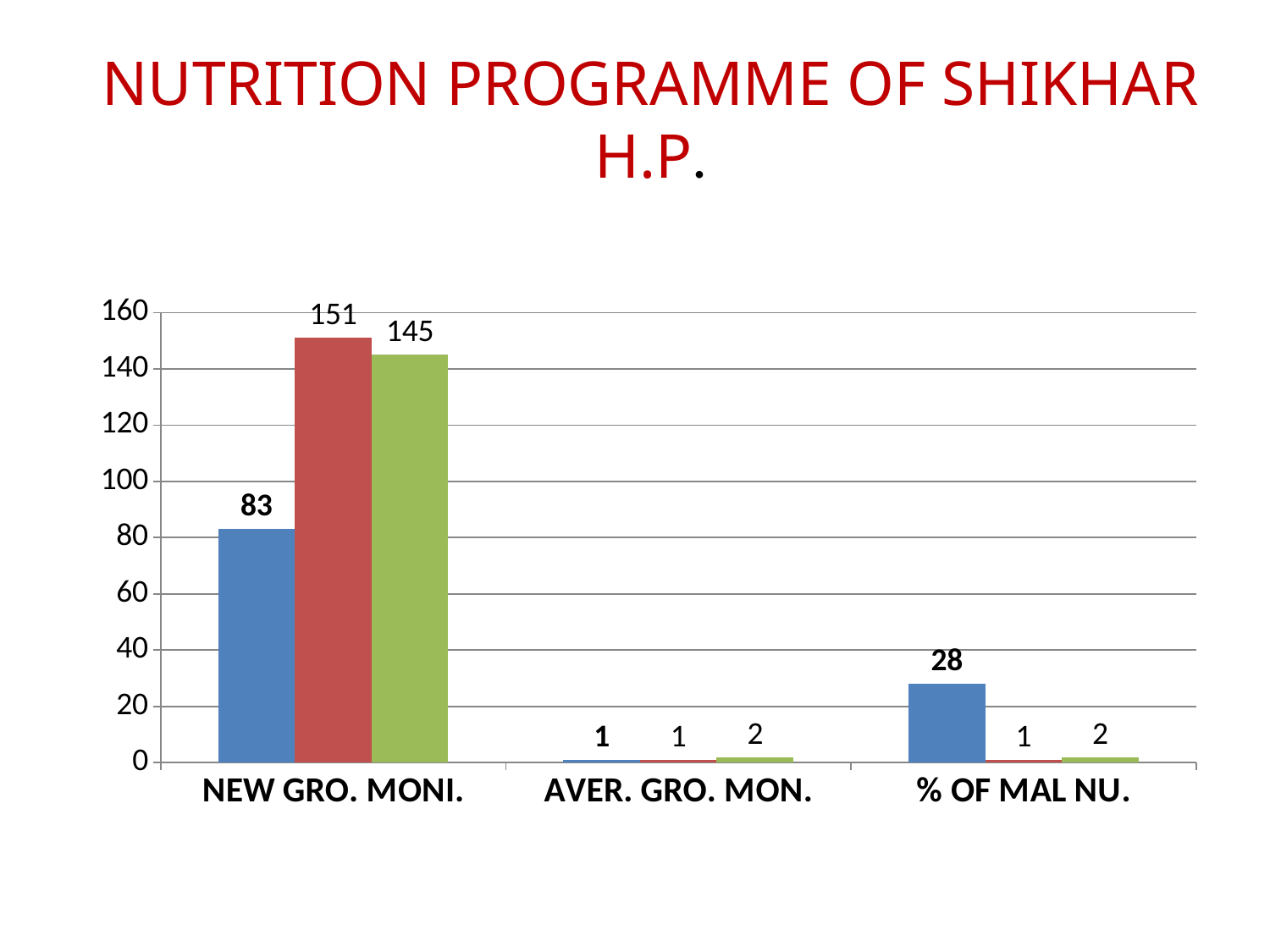
What is the value of the red bar for NEW GRO. MONI.? 151 For NEW GRO. MONI., which is larger, the red bar or the green bar? the red bar What is the value of the green bar for AVER. GRO. MON.? 2 What is the value of the blue bar for % OF MAL NU.? 28 Which category has the highest blue bar? NEW GRO. MONI. What is the difference between the red bar and the blue bar for NEW GRO. MONI.? 68 What kind of chart is shown on the slide? bar chart What is the value of the blue bar for NEW GRO. MONI.? 83 Which category has the lowest red bar? AVER. GRO. MON. and % OF MAL NU. (tied at 1) What is the value of the green bar for NEW GRO. MONI.? 145 How many categories are shown on the x axis? 3 Is the value of the blue bar for NEW GRO. MONI. greater or less than 100? less